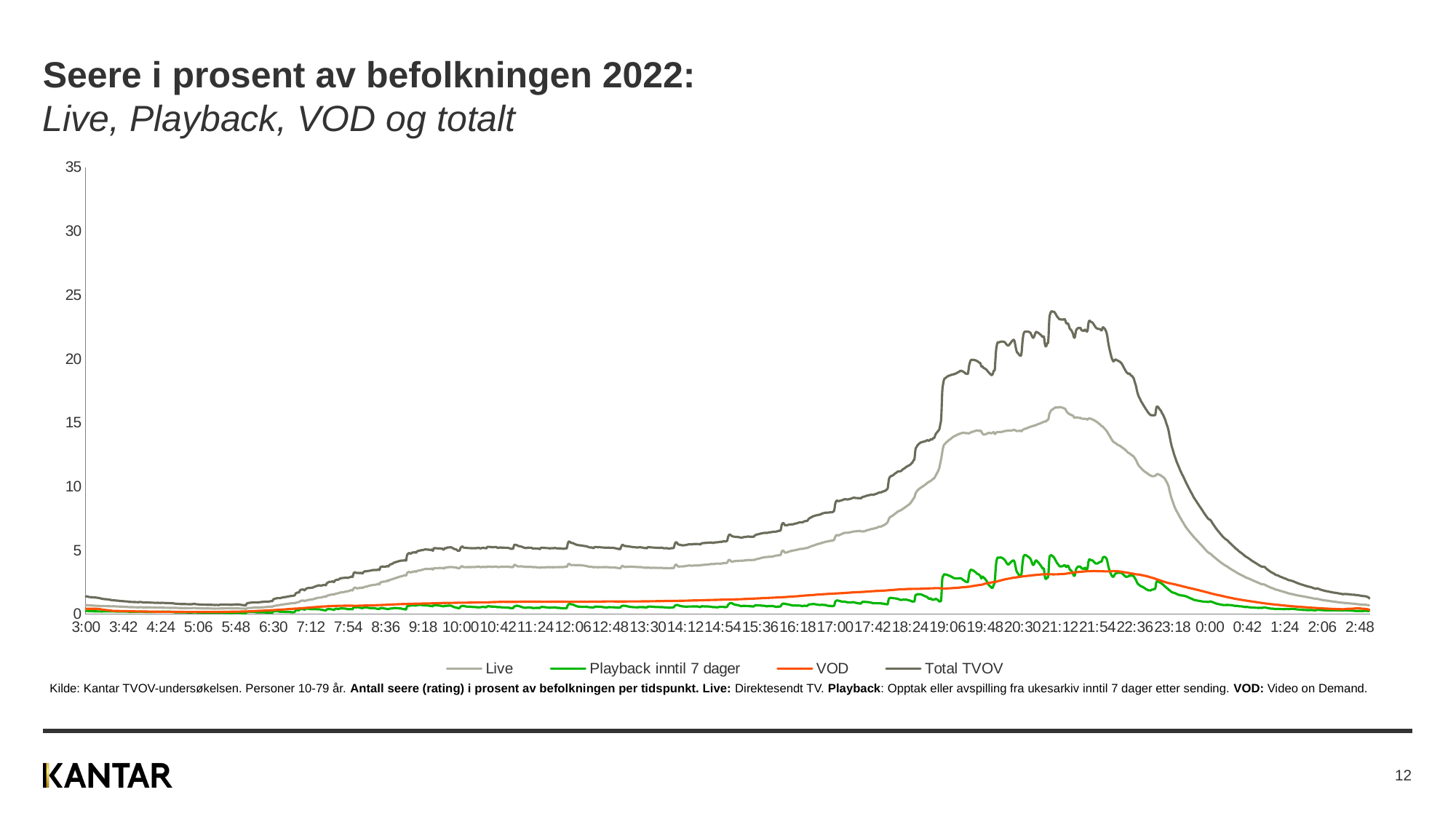
Which series reaches the highest value on the chart? Total TVOV Does the Total TVOV line rise or fall between 3:00 and 21:12? rise What kind of chart is shown on the slide? line chart Which is larger at 21:12, Total TVOV or Live? Total TVOV Does the Live line rise or fall between 21:54 and 2:48? fall Which series are listed in the legend? Live, Playback inntil 7 dager, VOD, Total TVOV Is the value for Live at 21:12 greater or less than 10? greater What is the highest value shown on the vertical axis? 35 Is the value for Total TVOV at 12:06 greater or less than 10? less Is the peak value of Total TVOV greater or less than 20? greater How many series does the legend list? 4